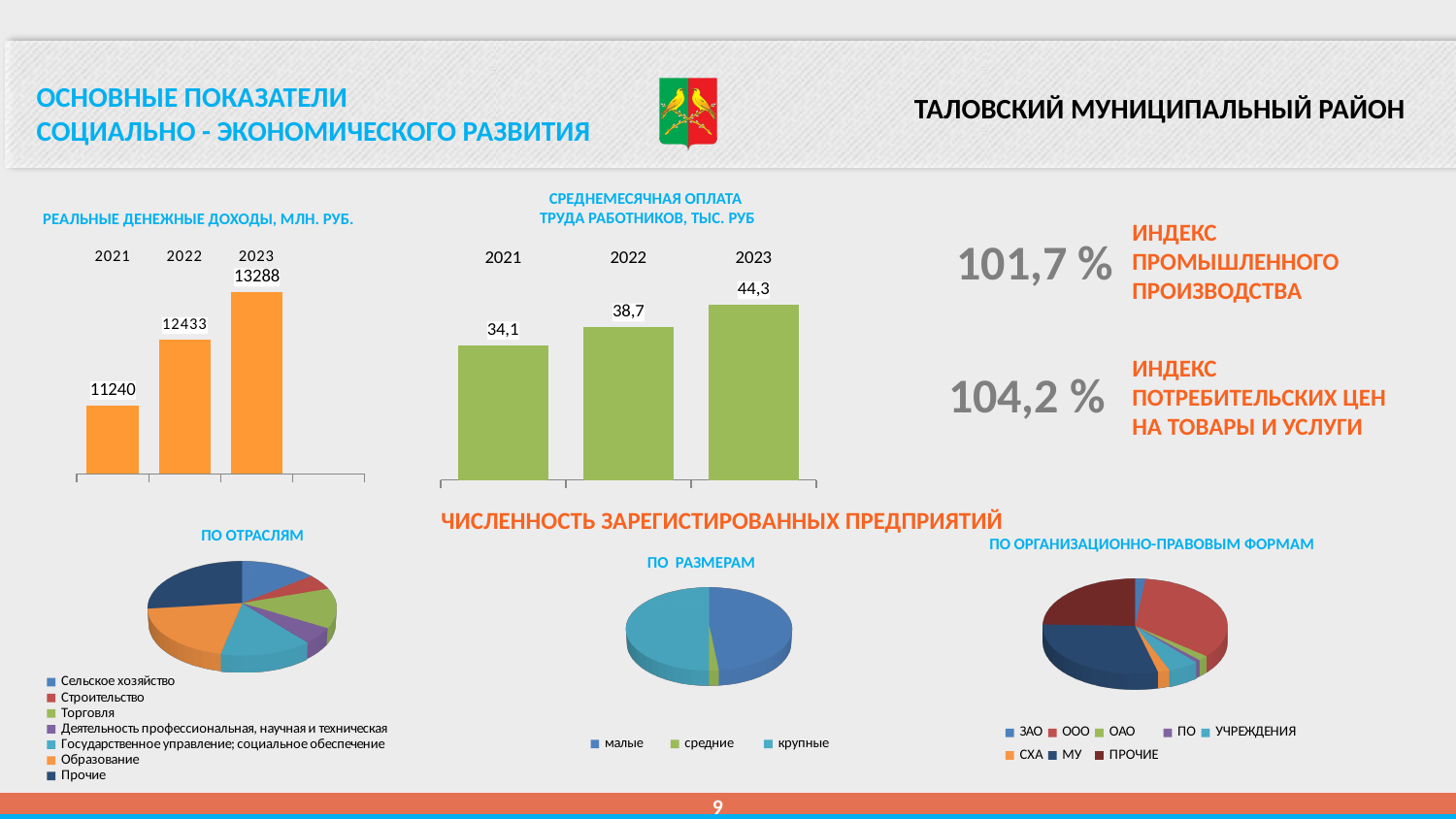
How many entries does the legend of the pie chart 'ПО РАЗМЕРАМ' list? 3 In the chart 'СРЕДНЕМЕСЯЧНАЯ ОПЛАТА ТРУДА РАБОТНИКОВ, ТЫС. РУБ', what is the value for 2021? 34,1 In the chart 'СРЕДНЕМЕСЯЧНАЯ ОПЛАТА ТРУДА РАБОТНИКОВ, ТЫС. РУБ', which is larger, the value for 2022 or the value for 2023? 2023 How many years are shown in the chart 'РЕАЛЬНЫЕ ДЕНЕЖНЫЕ ДОХОДЫ, МЛН. РУБ.'? 3 In the chart 'РЕАЛЬНЫЕ ДЕНЕЖНЫЕ ДОХОДЫ, МЛН. РУБ.', what is the value for 2022? 12433 In the chart 'СРЕДНЕМЕСЯЧНАЯ ОПЛАТА ТРУДА РАБОТНИКОВ, ТЫС. РУБ', what is the difference between the 2023 and 2021 values? 10,2 In the chart 'РЕАЛЬНЫЕ ДЕНЕЖНЫЕ ДОХОДЫ, МЛН. РУБ.', do the values rise or fall from 2021 to 2023? rise In the chart 'РЕАЛЬНЫЕ ДЕНЕЖНЫЕ ДОХОДЫ, МЛН. РУБ.', which year has the highest value? 2023 What kind of chart is 'СРЕДНЕМЕСЯЧНАЯ ОПЛАТА ТРУДА РАБОТНИКОВ, ТЫС. РУБ'? bar chart In the chart 'СРЕДНЕМЕСЯЧНАЯ ОПЛАТА ТРУДА РАБОТНИКОВ, ТЫС. РУБ', which year has the lowest value? 2021 What kind of chart is 'ПО ОРГАНИЗАЦИОННО-ПРАВОВЫМ ФОРМАМ'? pie chart In the chart 'РЕАЛЬНЫЕ ДЕНЕЖНЫЕ ДОХОДЫ, МЛН. РУБ.', what is the difference between the 2023 and 2022 values? 855